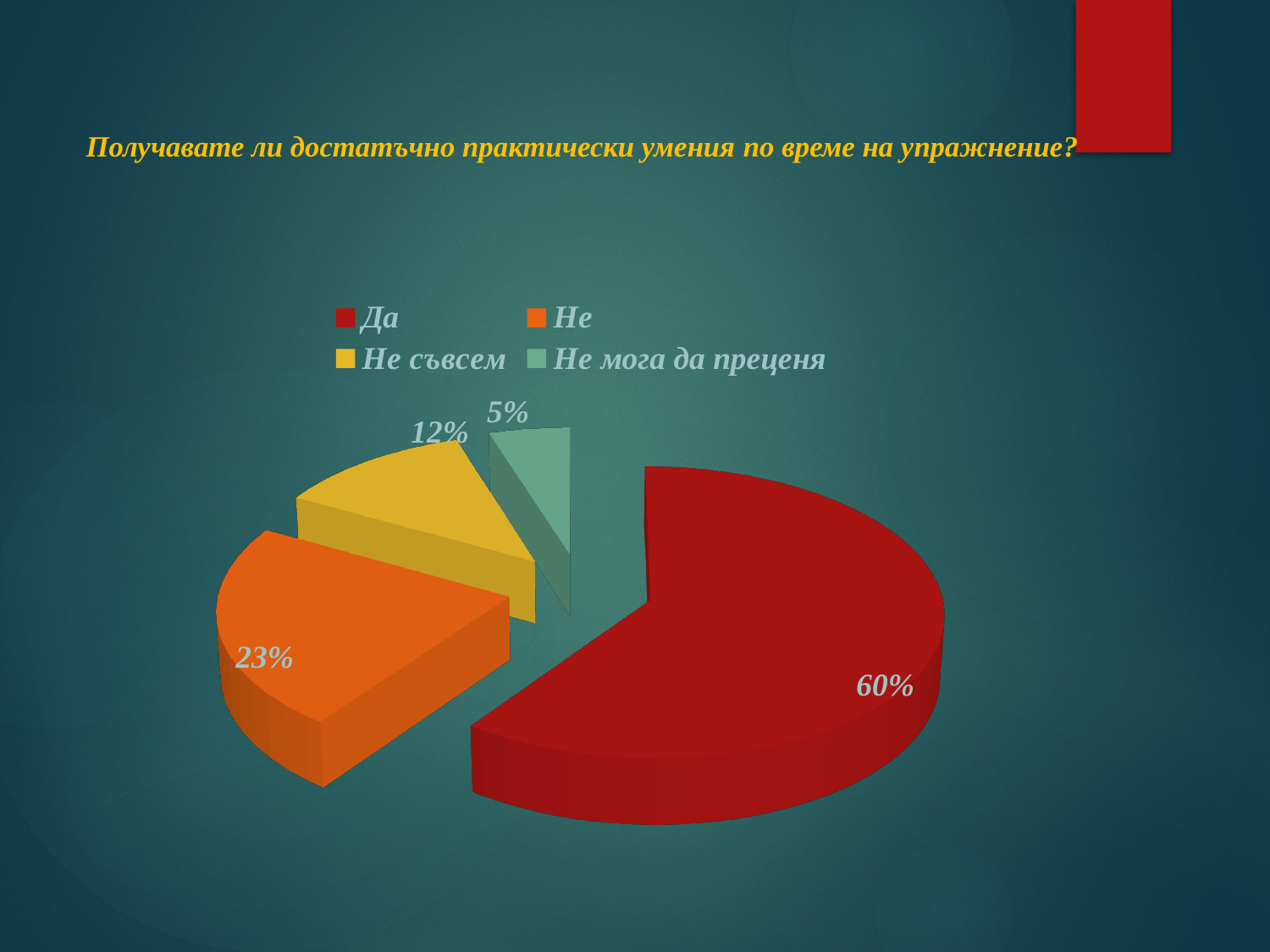
What share of the pie does "Не съвсем" have? 12% How many categories does the pie chart have? 4 What share of the pie does "Не" have? 23% Which is larger, the slice for "Не" or the slice for "Не съвсем"? Не Which category has the smallest slice of the pie? Не мога да преценя What is the difference in percentage points between "Да" and "Не"? 37 What kind of chart is shown on the slide? pie chart What share of the pie does "Да" have? 60% What is the title of the chart? Получавате ли достатъчно практически умения по време на упражнение? What colour is the slice for "Не съвсем"? yellow Which category has the largest slice of the pie? Да